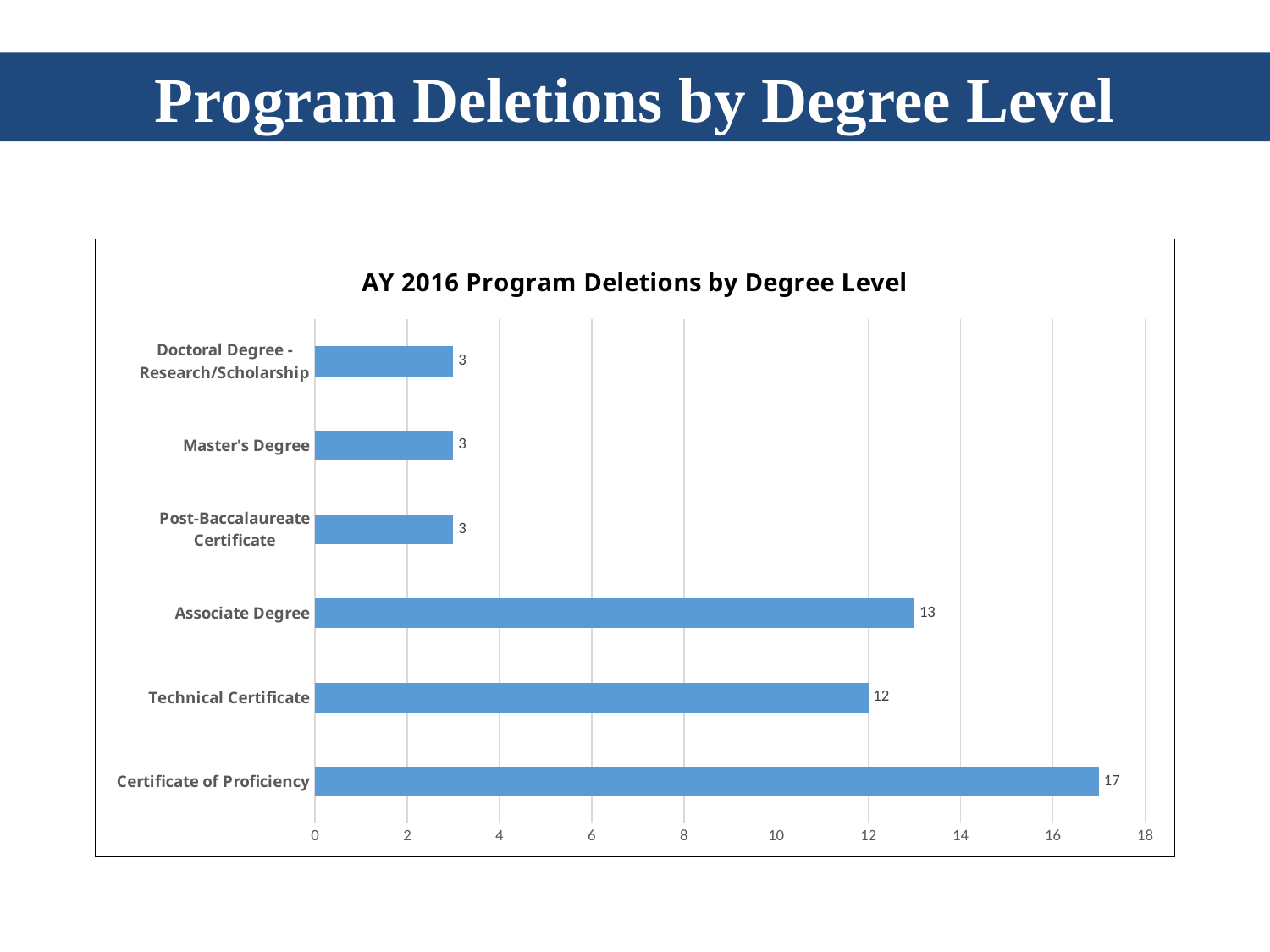
What is the value for Associate Degree? 13 What is the value for Master's Degree? 3 What is the difference between the values for Certificate of Proficiency and Associate Degree? 4 Which is larger, the value for Technical Certificate or the value for Post-Baccalaureate Certificate? Technical Certificate What kind of chart is shown on the slide? bar chart How many degree level categories are shown in the chart? 6 What is the difference between the values for Associate Degree and Technical Certificate? 1 Which degree level has the highest number of program deletions? Certificate of Proficiency Is the value for Certificate of Proficiency greater or less than 16? greater What is the value for Technical Certificate? 12 What is the title of the chart? AY 2016 Program Deletions by Degree Level What is the value for Certificate of Proficiency? 17